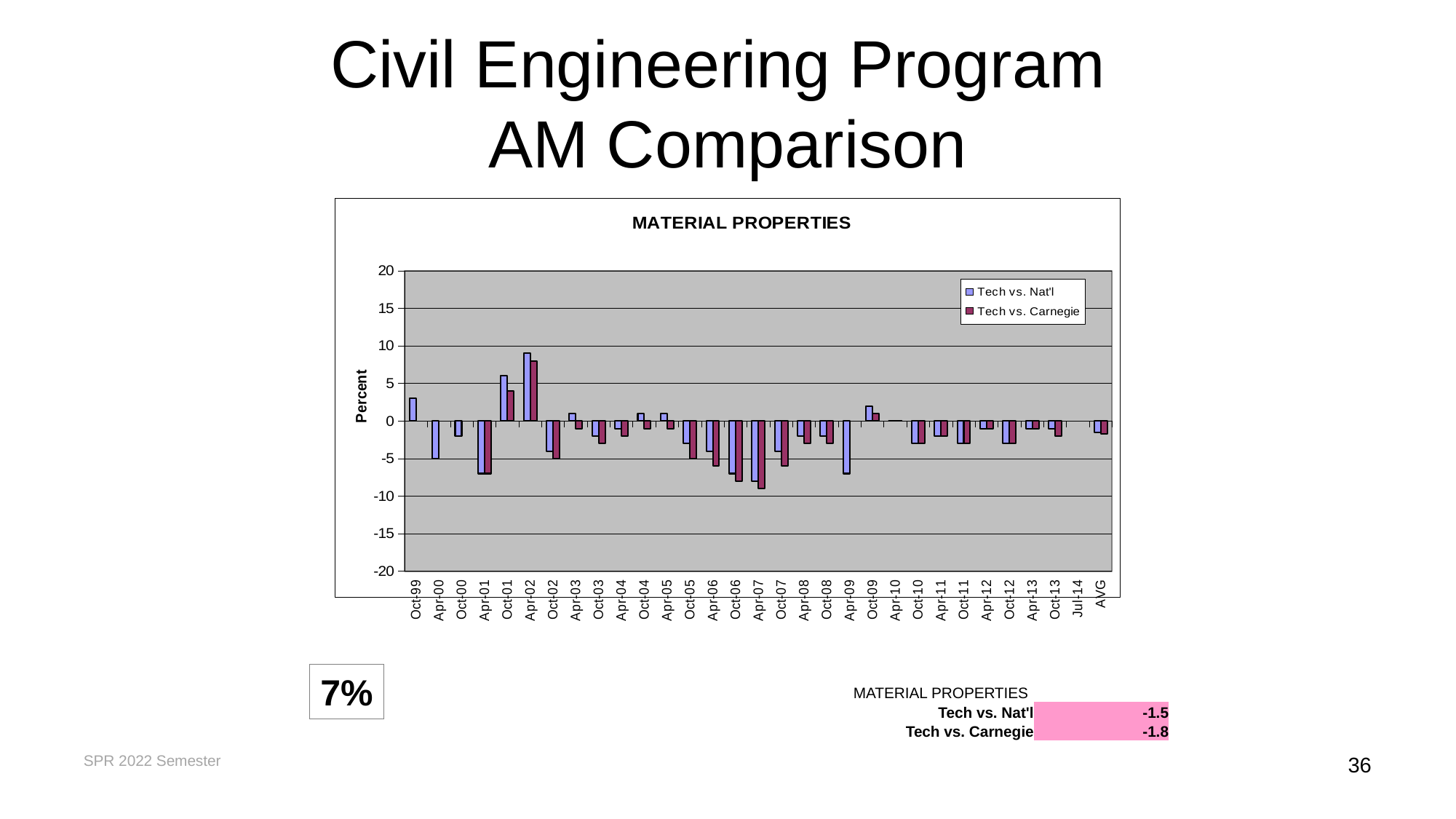
What type of chart is shown on the slide? Bar chart Which series has the larger AVG value, Tech vs. Nat'l or Tech vs. Carnegie? Tech vs. Nat'l What is the AVG value for Tech vs. Carnegie? -1.8 What is the AVG value for Tech vs. Nat'l? -1.5 What is the title of the chart? MATERIAL PROPERTIES In which period is the Tech vs. Nat'l value highest? Apr-02 How many series does the chart legend list? 2 What is the label on the vertical axis of the chart? Percent What is the difference between the AVG values for Tech vs. Nat'l and Tech vs. Carnegie? 0.3 Is the Tech vs. Nat'l value for Apr-02 greater or less than 5? greater Is the Tech vs. Carnegie value for Apr-07 greater or less than -5? less How many categories are shown along the x axis of the chart, including AVG? 31